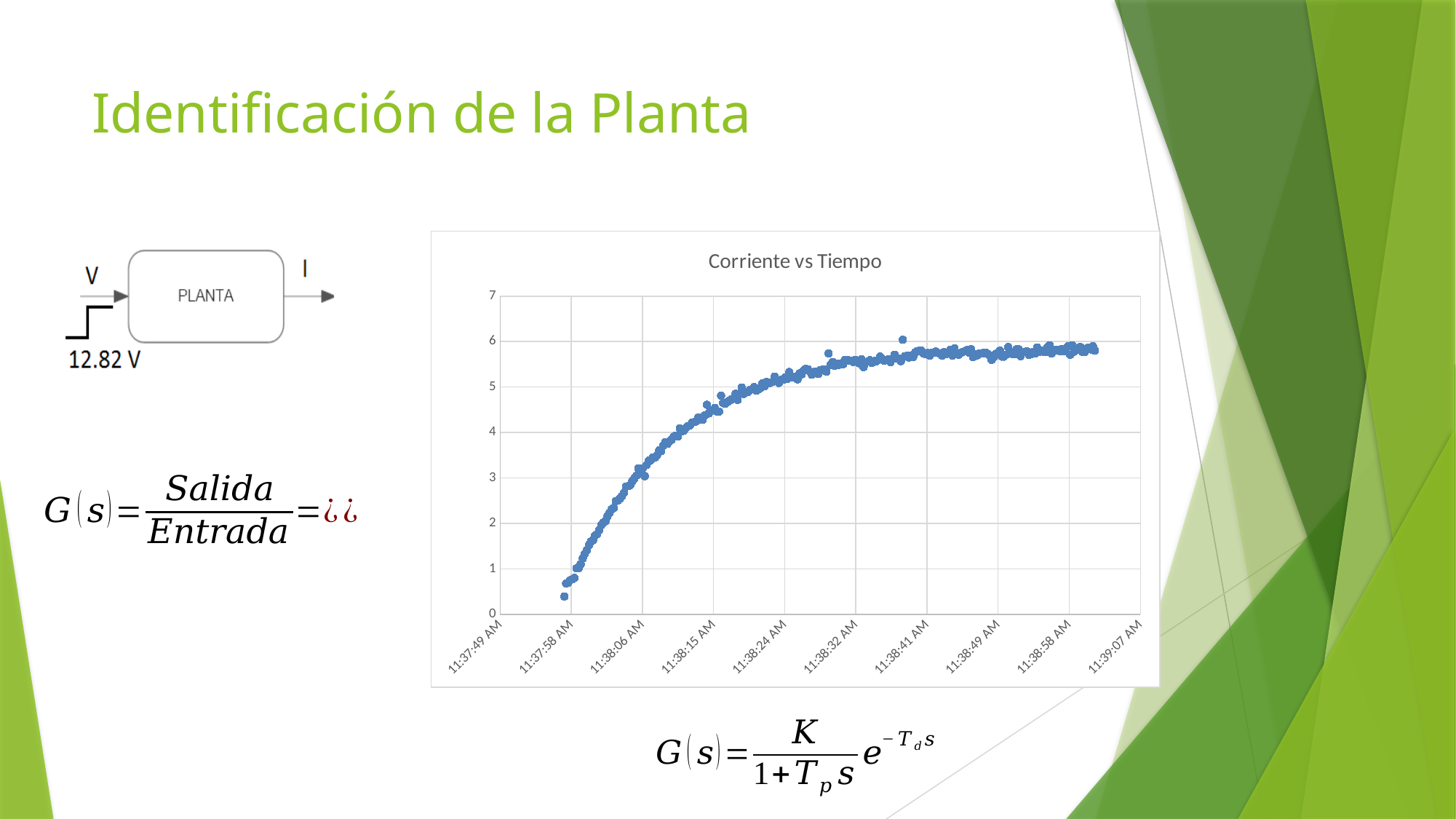
In the 'Corriente vs Tiempo' chart, is the lowest plotted value greater or less than 1? less In the 'Corriente vs Tiempo' chart, is the value at 11:38:49 AM greater or less than 5? greater In the 'Corriente vs Tiempo' chart, is the value at 11:38:58 AM greater or less than 6? less Do the plotted values rise or fall along the x axis in the 'Corriente vs Tiempo' chart? rise What kind of chart is shown on the slide? scatter chart What is the title of the chart on the slide? Corriente vs Tiempo In the 'Corriente vs Tiempo' chart, which is larger: the value at 11:38:06 AM or the value at 11:38:24 AM? 11:38:24 AM What is the maximum value shown on the y axis of the 'Corriente vs Tiempo' chart? 7